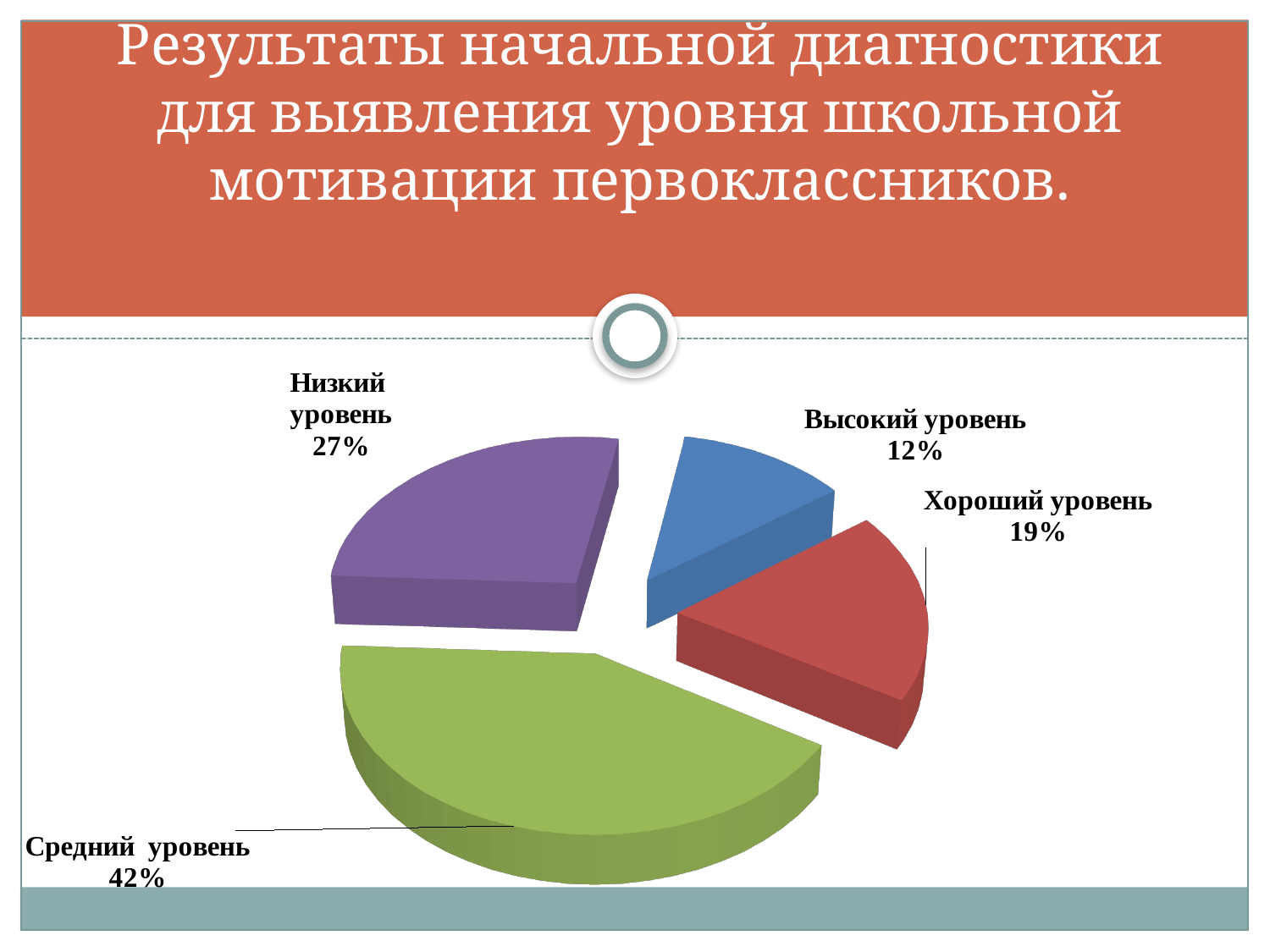
What share of the pie does "Средний уровень" have? 42% How many categories are shown in the pie chart? 4 What kind of chart is shown on the slide? Pie chart What is the value shown for "Низкий уровень"? 27% Which category has the smallest slice of the pie? Высокий уровень What is the value shown for "Хороший уровень"? 19% What is the difference between the values for "Средний уровень" and "Низкий уровень"? 15% What colour is the slice for "Средний уровень"? Green Which is larger, the value for "Низкий уровень" or the value for "Хороший уровень"? Низкий уровень Which category has the largest slice of the pie? Средний уровень What is the difference between the values for "Хороший уровень" and "Высокий уровень"? 7% What is the value shown for "Высокий уровень"? 12%